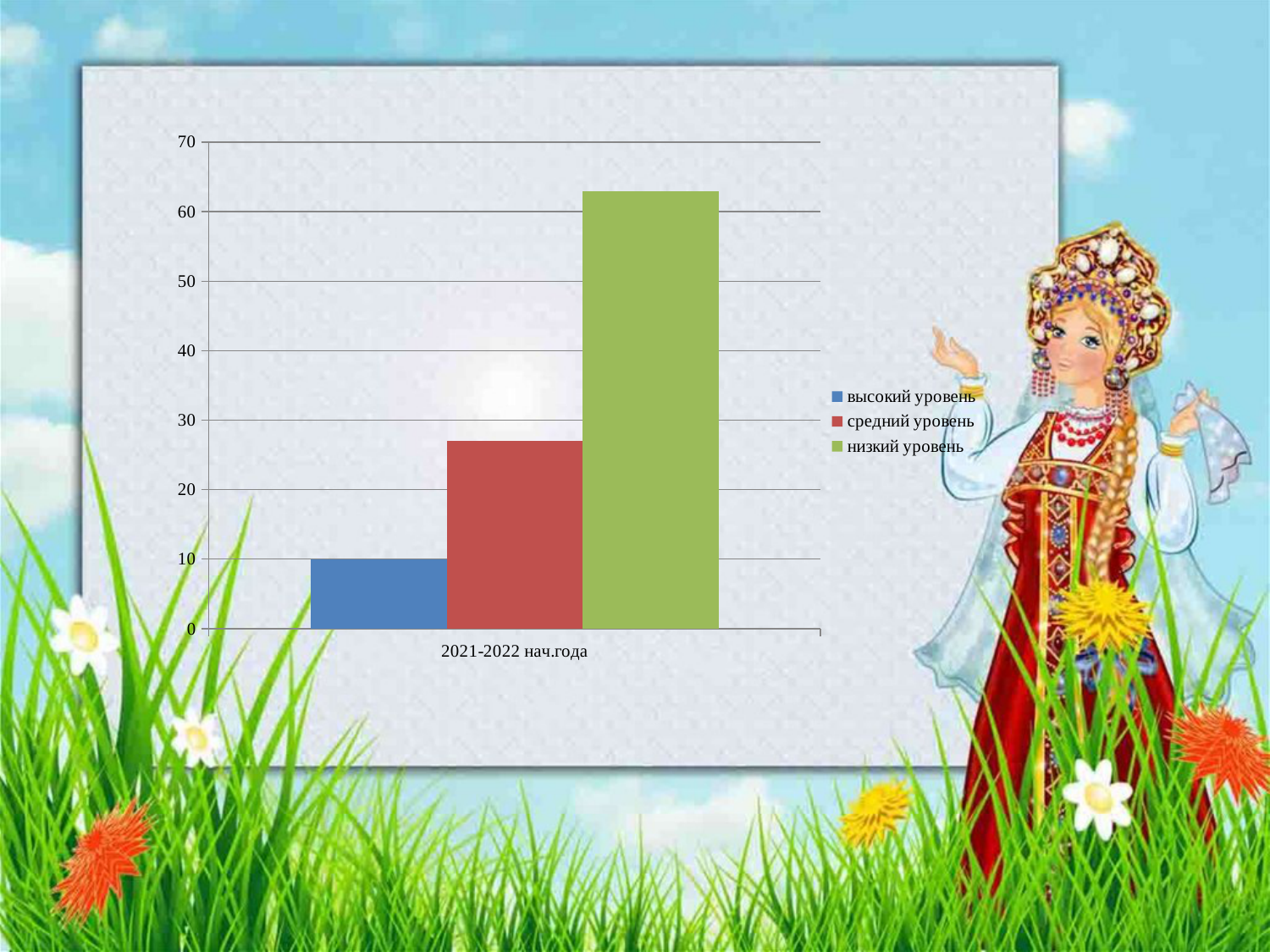
Which series has the lowest value for 2021-2022 нач.года? высокий уровень What colour represents низкий уровень in the legend? green Which series has the highest value for 2021-2022 нач.года? низкий уровень What is the category label shown on the x axis? 2021-2022 нач.года Is the value for средний уровень greater or less than 20? greater How many categories are shown on the x axis? 1 Is the value for средний уровень greater or less than 30? less What kind of chart is shown on the slide? bar chart Is the value for высокий уровень greater or less than 20? less Which is larger for 2021-2022 нач.года: средний уровень or высокий уровень? средний уровень How many series does the legend list? 3